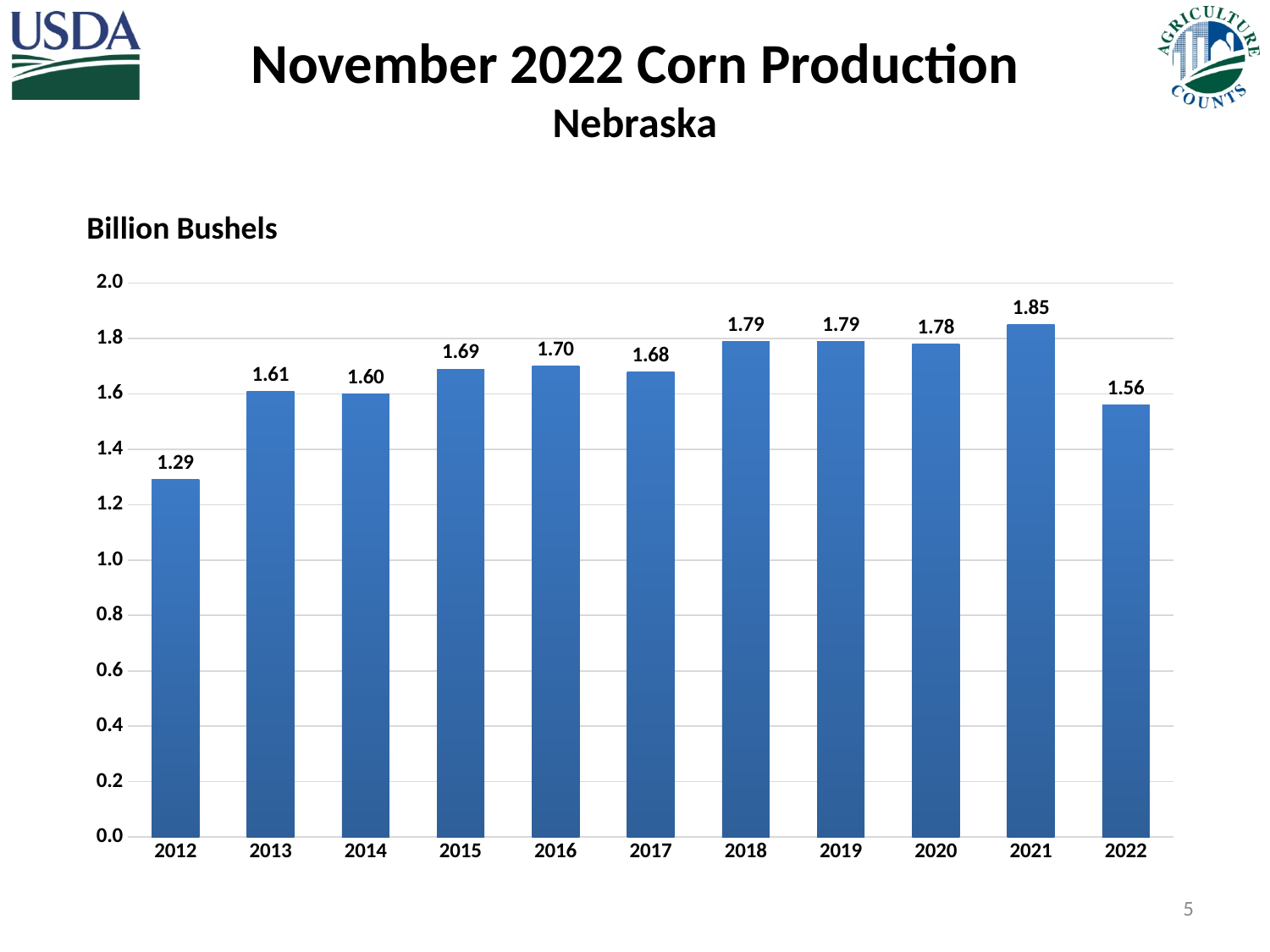
Which year had the highest corn production? 2021 What is the difference in corn production between 2013 and 2012, in billion bushels? 0.32 What unit is the y axis measured in, according to the label above the chart? Billion Bushels Which year had the lowest corn production? 2012 What was Nebraska's corn production in 2012, in billion bushels? 1.29 Is the value for 2022 greater or less than 1.6? less What is the difference in corn production between 2021 and 2022, in billion bushels? 0.29 How many years are shown on the chart? 11 Which year had higher corn production, 2015 or 2016? 2016 What kind of chart is shown on the slide? Bar chart What was Nebraska's corn production in 2017, in billion bushels? 1.68 What was Nebraska's corn production in 2022, in billion bushels? 1.56